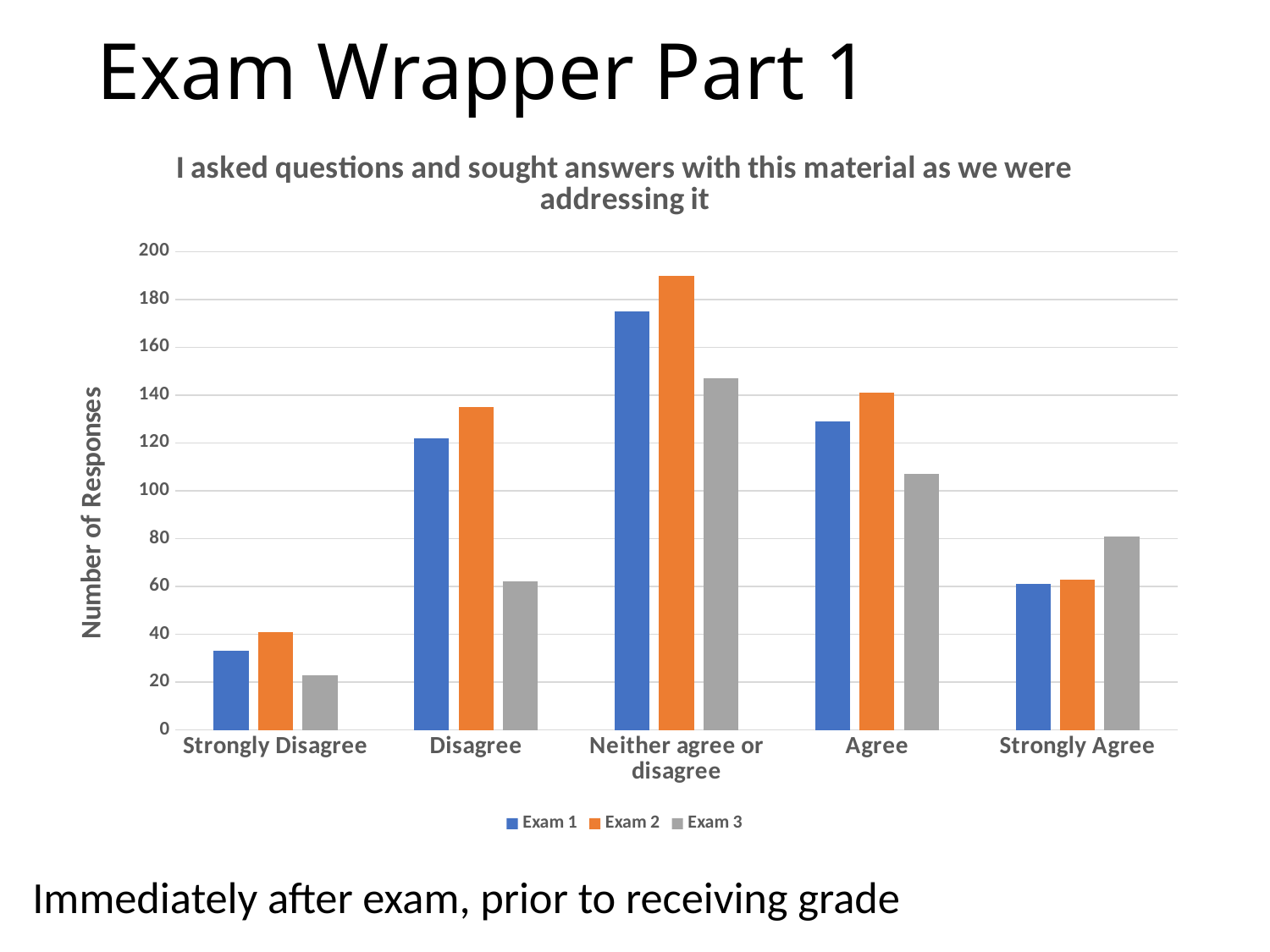
How many series does the legend list? 3 What kind of chart is shown on the slide? bar chart Which response category has the lowest number of responses for Exam 3? Strongly Disagree For Strongly Agree, which exam has more responses: Exam 1 or Exam 3? Exam 3 Is the Exam 1 value for Agree greater or less than 120? greater How many response categories are shown on the x axis? 5 For Disagree, which exam has more responses: Exam 2 or Exam 3? Exam 2 Is the Exam 3 value for Disagree greater or less than 80? less What is the label of the y axis? Number of Responses Is the Exam 3 value for Strongly Disagree greater or less than 40? less Which response category has the highest number of responses for Exam 2? Neither agree or disagree